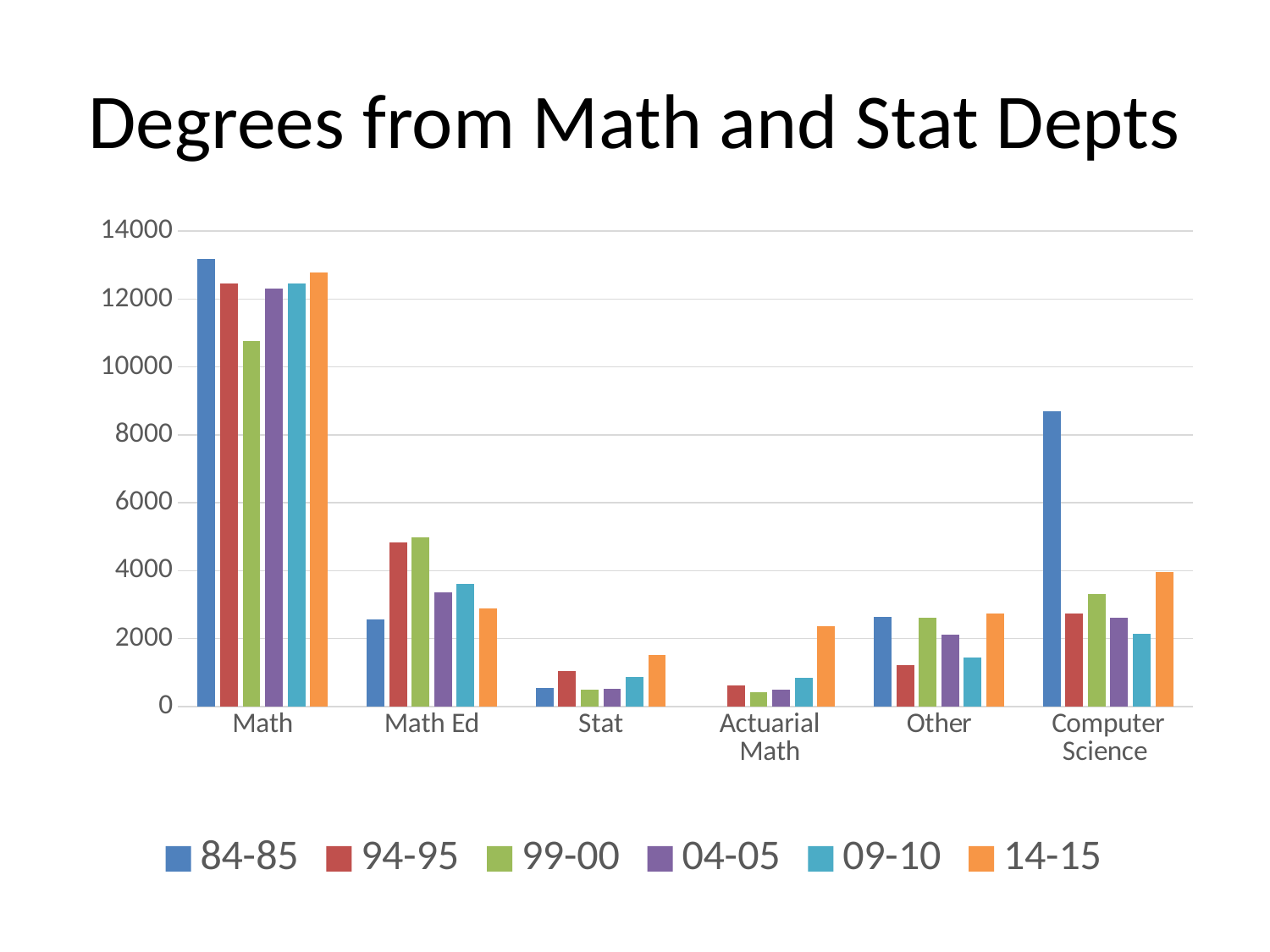
What colour represents the 14-15 series in the legend? orange What kind of chart is shown on the slide? bar chart How many series does the legend list? 6 For Stat, which is larger: the 94-95 value or the 14-15 value? 14-15 Which category has the highest value for the 84-85 series? Math Is the value for Computer Science in 84-85 greater or less than 8000? greater Is the value for Math in 99-00 greater or less than 12000? less Is the value for Actuarial Math in 14-15 greater or less than 2000? greater What is the title of the chart? Degrees from Math and Stat Depts Within the Math category, which series has the lowest value? 99-00 For Math Ed, which is larger: the 84-85 value or the 94-95 value? 94-95 How many categories are shown along the x axis? 6